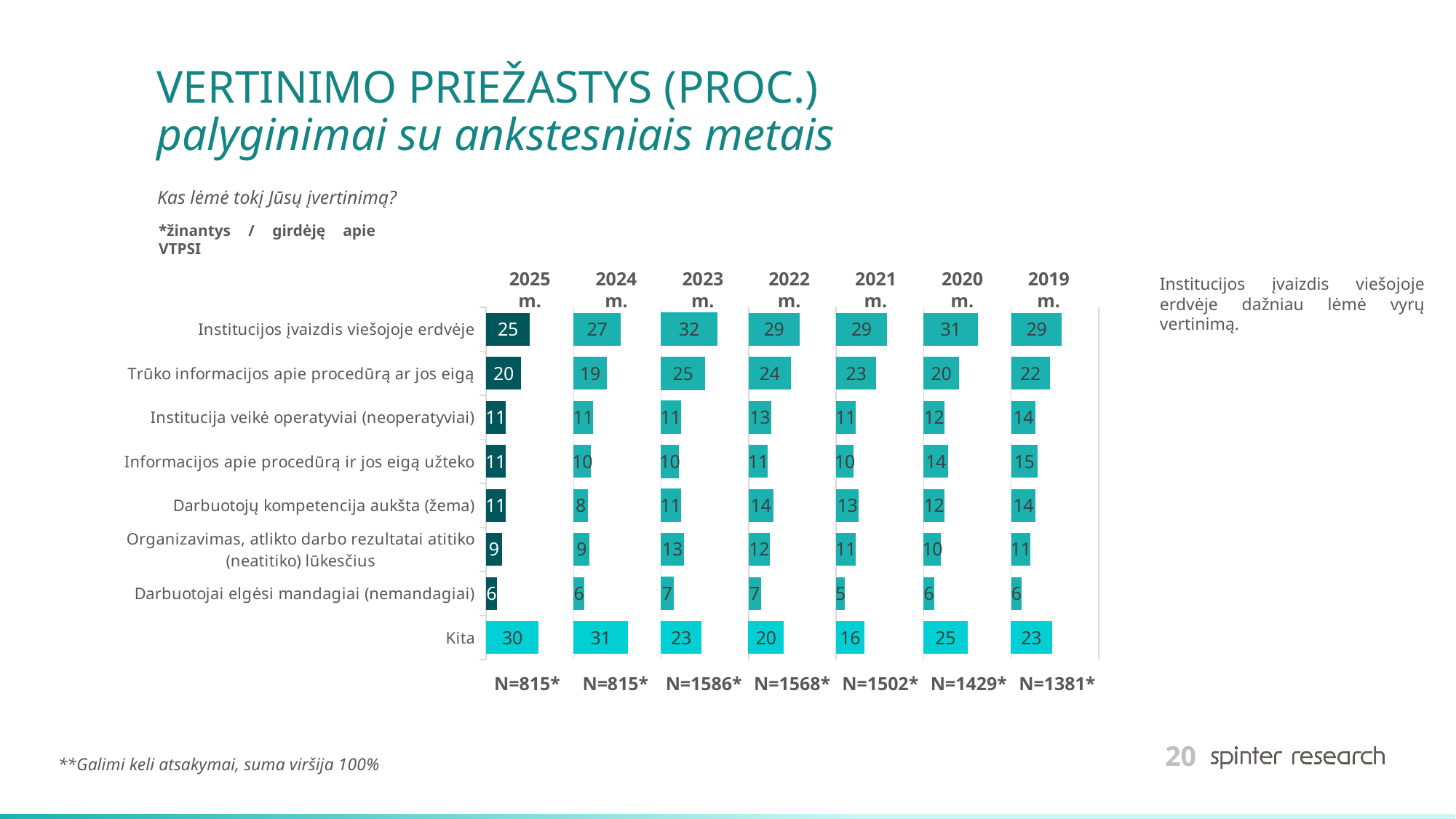
In the 2024 m. chart, which category has the highest value? Kita In the 2021 m. chart, what is the value for "Kita"? 16 In the 2022 m. chart, which category has the lowest value? Darbuotojai elgėsi mandagiai (nemandagiai) In the 2025 m. chart, what is the value for "Institucijos įvaizdis viešojoje erdvėje"? 25 In the 2019 m. chart, what is the value for "Informacijos apie procedūrą ir jos eigą užteko"? 15 For "Darbuotojų kompetencija aukšta (žema)", which year has the larger value: 2024 m. or 2022 m.? 2022 m. How many years are compared on the slide? 7 What kind of chart is used on the slide? Bar chart What is the difference between the 2023 m. and 2025 m. values for "Institucijos įvaizdis viešojoje erdvėje"? 7 How many categories are listed in each year's chart? 8 What is the sample size (N) shown for the 2023 m. chart? N=1586* In the 2023 m. chart, what is the value for "Trūko informacijos apie procedūrą ar jos eigą"? 25